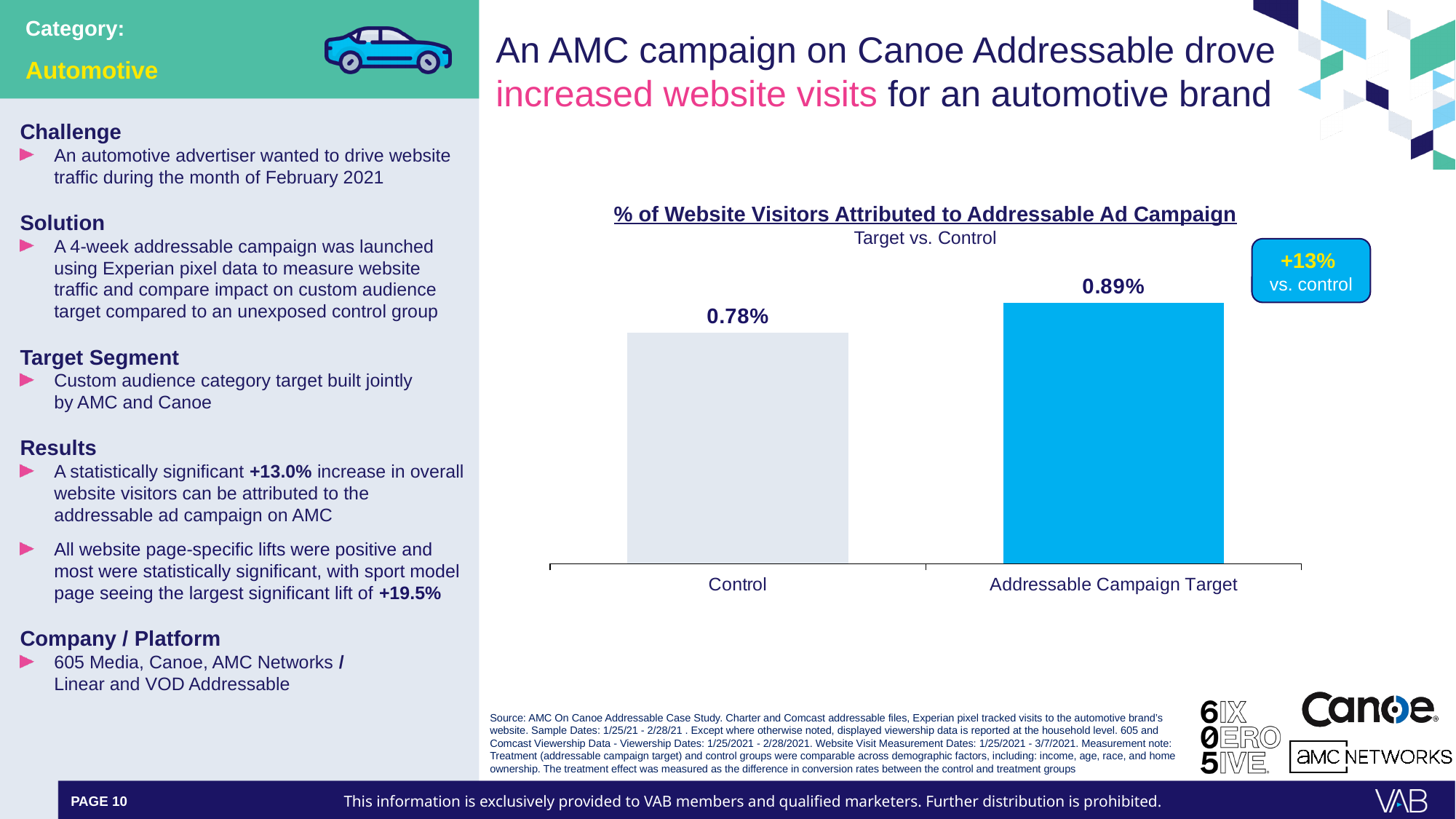
What is the value for Addressable Campaign Target? 0.89% What is the value for Control? 0.78% Which category has the highest value? Addressable Campaign Target Which is larger, the value for Control or the value for Addressable Campaign Target? Addressable Campaign Target What is the difference between the Addressable Campaign Target value and the Control value? 0.11% What kind of chart is shown on the slide? Bar chart What is the title of the chart? % of Website Visitors Attributed to Addressable Ad Campaign Which category has the lowest value? Control How many categories are shown on the chart? 2 What lift vs. control is shown in the callout next to the chart? +13%